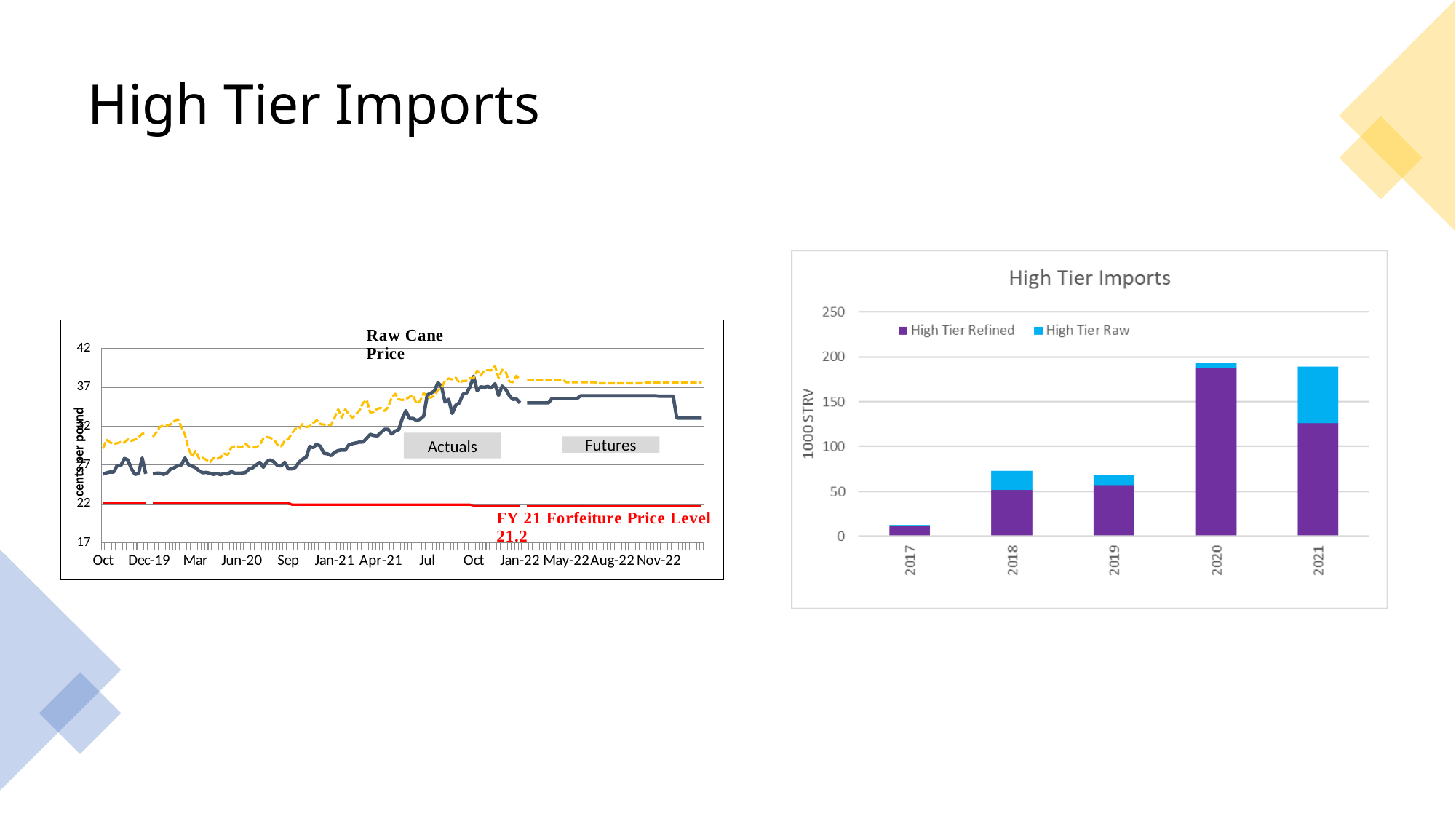
What type of chart is the High Tier Imports chart on the right? bar chart What is the y-axis label of the High Tier Imports chart? 1000 STRV In the High Tier Imports chart, which year has the lowest total imports? 2017 In the High Tier Imports chart, which year has the larger High Tier Refined value, 2020 or 2021? 2020 In the Raw Cane Price chart, what is the FY 21 Forfeiture Price Level? 21.2 How many years are shown on the x axis of the High Tier Imports chart? 5 How many series does the legend of the High Tier Imports chart list? 2 What type of chart is the Raw Cane Price chart on the left? line chart In the High Tier Imports chart, which year has the larger High Tier Raw value, 2020 or 2021? 2021 In the High Tier Imports chart, is the total for 2020 greater or less than 150? greater In the High Tier Imports chart, is the total for 2017 greater or less than 50? less In the High Tier Imports chart, is the total for 2019 greater or less than 100? less